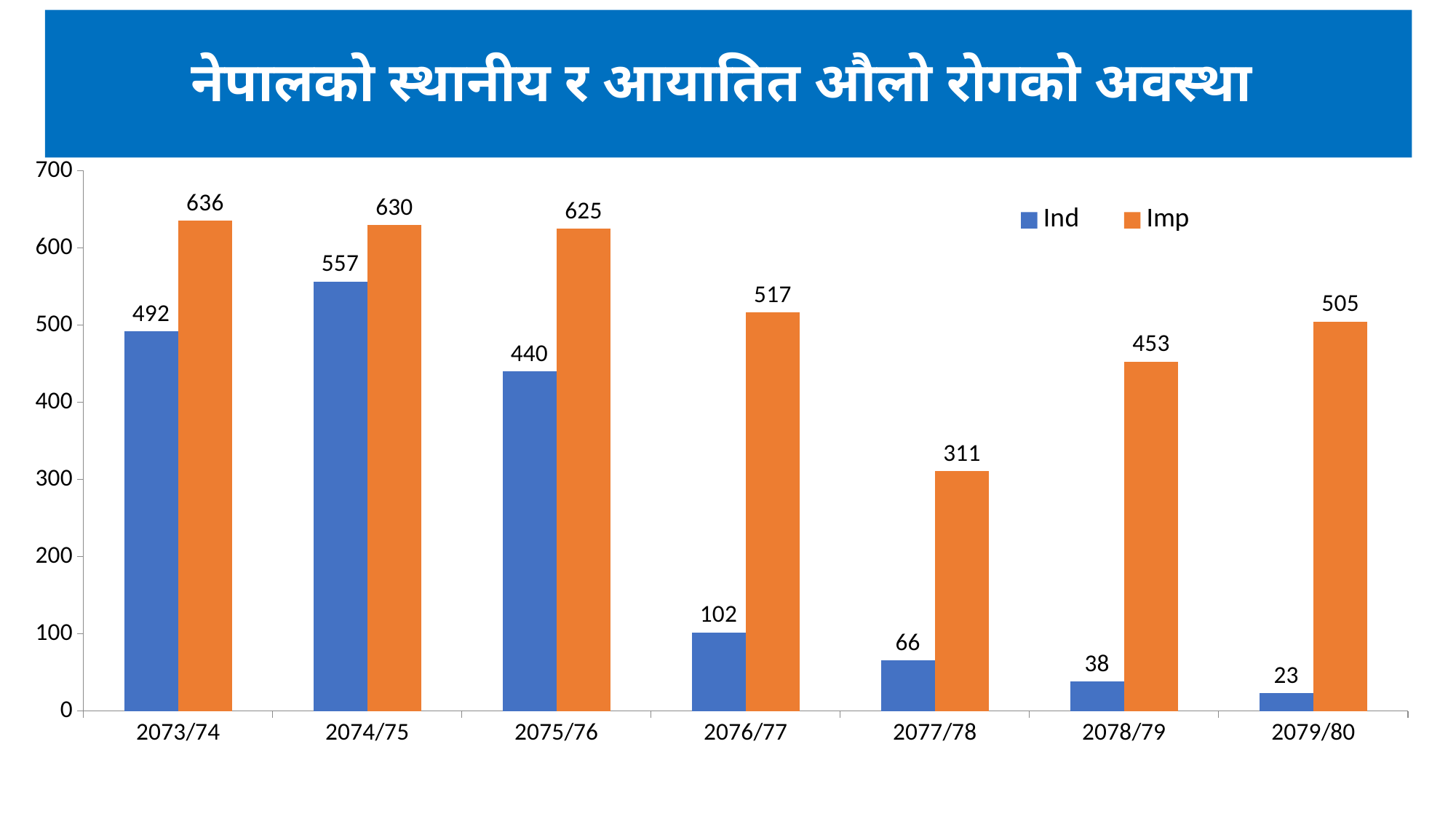
How many years are shown on the x axis? 7 Is the Imp value for 2078/79 greater or less than 400? greater What is the Imp value for 2077/78? 311 What is the difference between the Imp and Ind values for 2076/77? 415 Do the Ind values rise or fall from 2074/75 to 2079/80? fall How many series does the legend list? 2 Which year has the highest Imp value? 2073/74 What is the Ind value for 2079/80? 23 Which year has the lowest Ind value? 2079/80 Which is larger, the Ind value for 2073/74 or the Ind value for 2075/76? Ind value for 2073/74 What is the Ind value for 2074/75? 557 What kind of chart is shown on the slide? bar chart